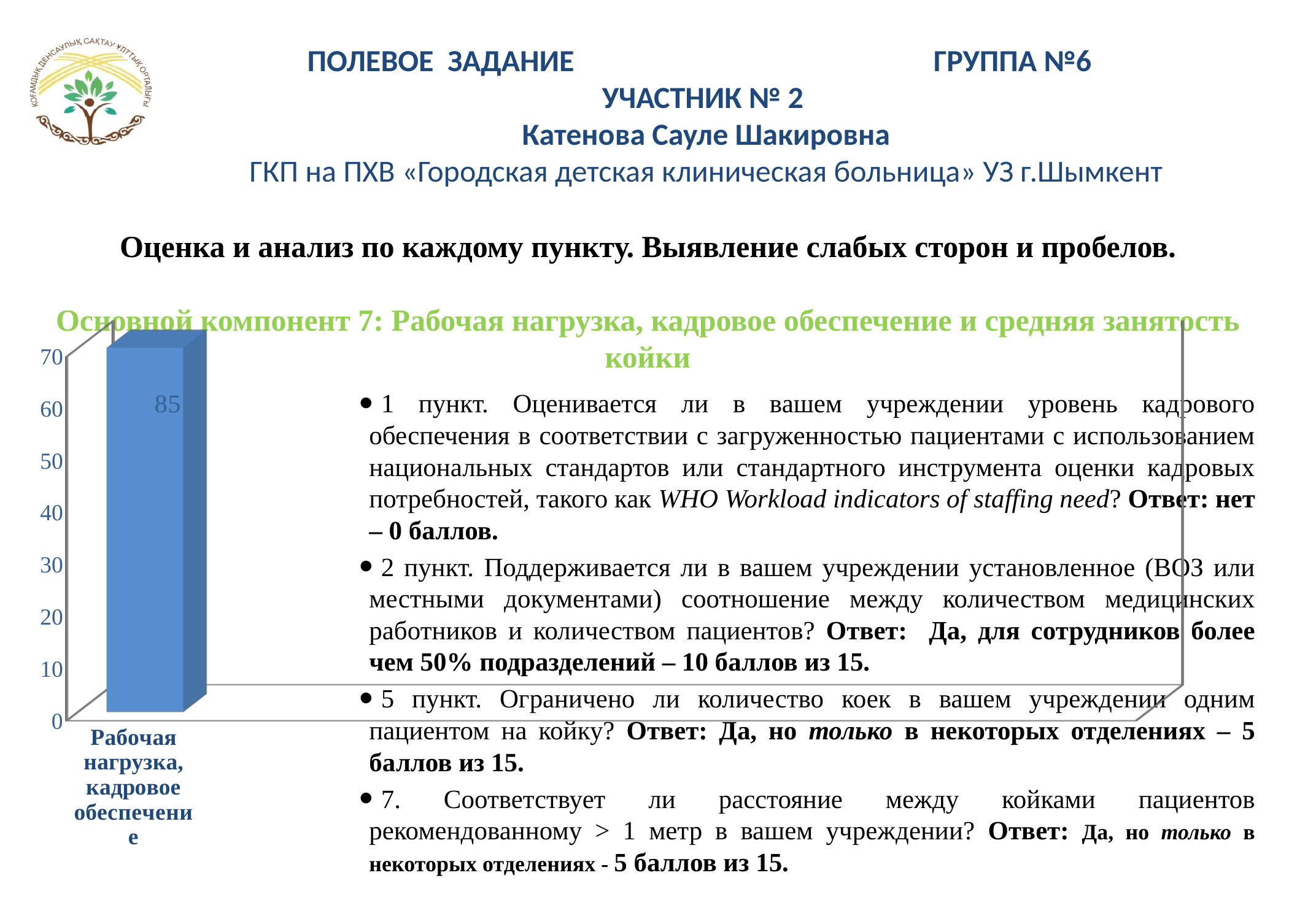
Is the value for "Рабочая нагрузка, кадровое обеспечение" greater or less than 50? greater What value is shown for the bar labelled "Рабочая нагрузка, кадровое обеспечение"? 85 What kind of chart is shown on the slide? bar chart How many bars are plotted in the chart? 1 What is the highest tick value shown on the vertical axis of the chart? 70 What is the label of the category on the x axis of the chart? Рабочая нагрузка, кадровое обеспечение What colour is the bar in the chart? blue